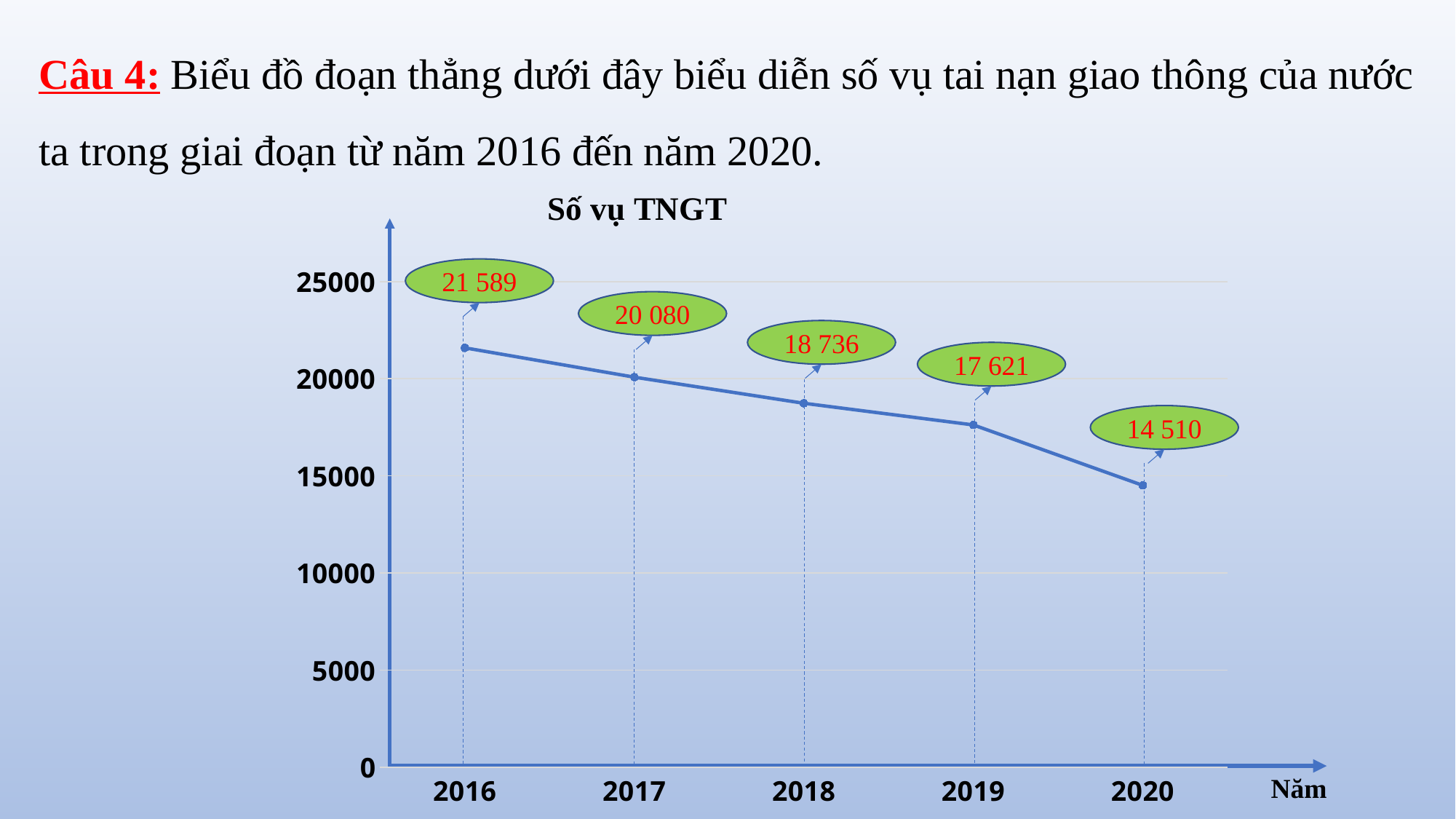
Which is larger, the value for 2017 or the value for 2019? 2017 Is the value for 2019 greater or less than 15000? greater What type of chart is shown on the slide? line chart Do the values rise or fall from 2016 to 2020? fall Which year has the highest value? 2016 How many years are plotted on the chart? 5 What is the value for 2018? 18 736 What is the value for 2016? 21 589 What is the value for 2020? 14 510 What is the difference between the values for 2017 and 2018? 1 344 Which year has the lowest value? 2020 What is the difference between the values for 2016 and 2020? 7 079